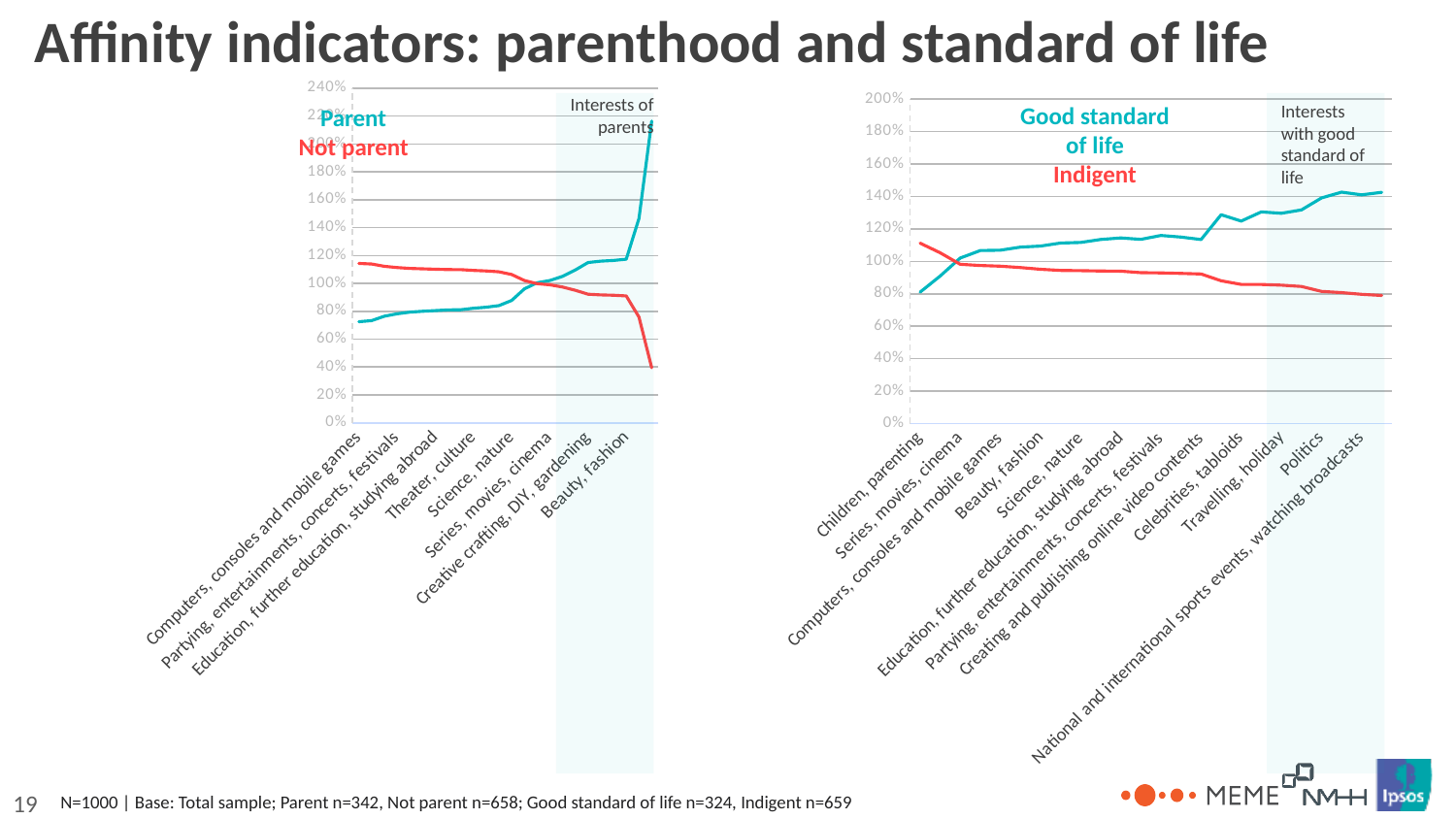
In the right chart, for which category is the Good standard of life value lowest? Children, parenting How many series does the left chart (Parent / Not parent) show? 2 In the left chart, does the Parent line rise or fall along the x axis? Rise In the right chart, does the Indigent line rise or fall along the x axis? Fall In the left chart, for Computers, consoles and mobile games, which series has the larger value: Parent or Not parent? Not parent In the right chart, is the Indigent value for Children, parenting greater or less than 100%? greater What type of chart is the left chart (Parent / Not parent)? Line chart